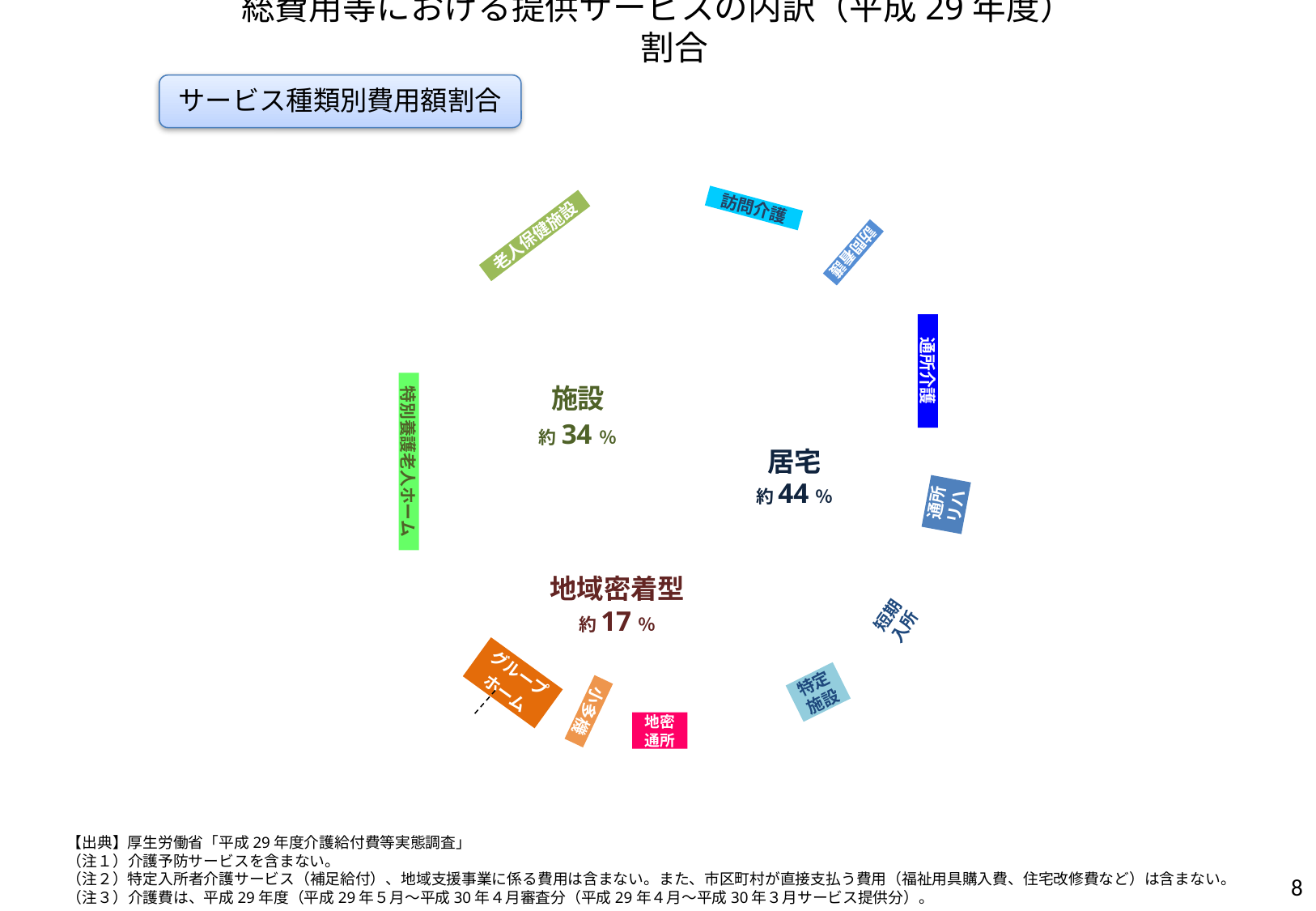
Which has the larger share, 施設 or 地域密着型? 施設 What share is shown for 居宅 on the chart? 約44% Which service label on the chart is shown on a pink/magenta background? 地密通所 Which has the larger share, 居宅 or 施設? 居宅 What share is shown for 施設 on the chart? 約34% What is the title shown in the box at the top left of the chart? サービス種類別費用額割合 How many main categories with percentage values are labelled on the chart? 3 Which of the three main categories (施設, 居宅, 地域密着型) has the largest share? 居宅 What share is shown for 地域密着型 on the chart? 約17% Which of the three main categories (施設, 居宅, 地域密着型) has the smallest share? 地域密着型